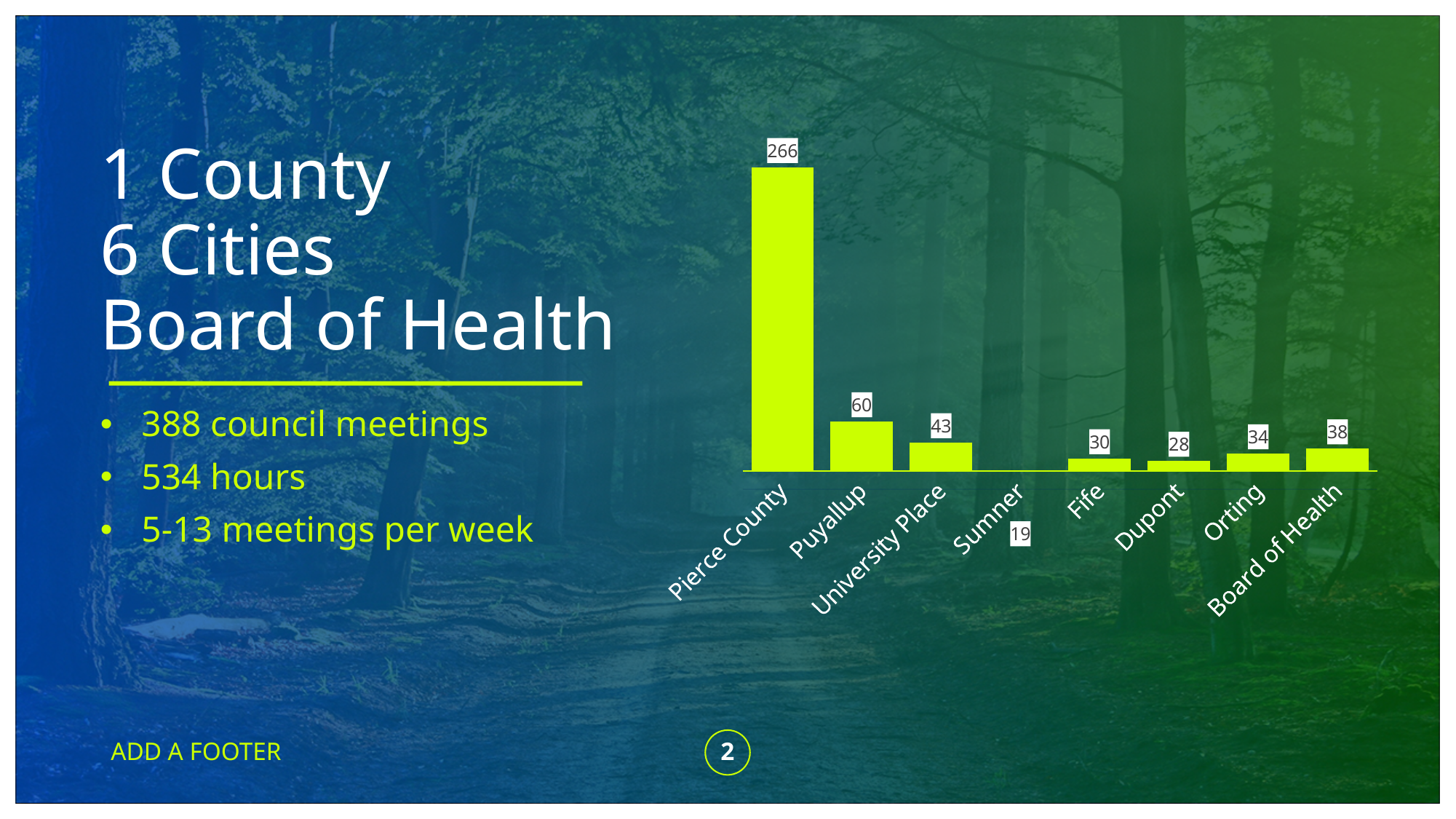
What is the difference between the values for Orting and Dupont? 6 What is the difference between the values for Pierce County and Puyallup? 206 What value is shown for Pierce County? 266 Which category has the highest value? Pierce County Which category has the lowest labelled value? Sumner Which is larger, the value for Fife or the value for Board of Health? Board of Health What value is shown for University Place? 43 What value is shown for Puyallup? 60 What kind of chart is shown on the slide? Bar chart What value is shown for Board of Health? 38 What value is labelled for Sumner? 19 How many categories are shown on the x axis of the chart? 8